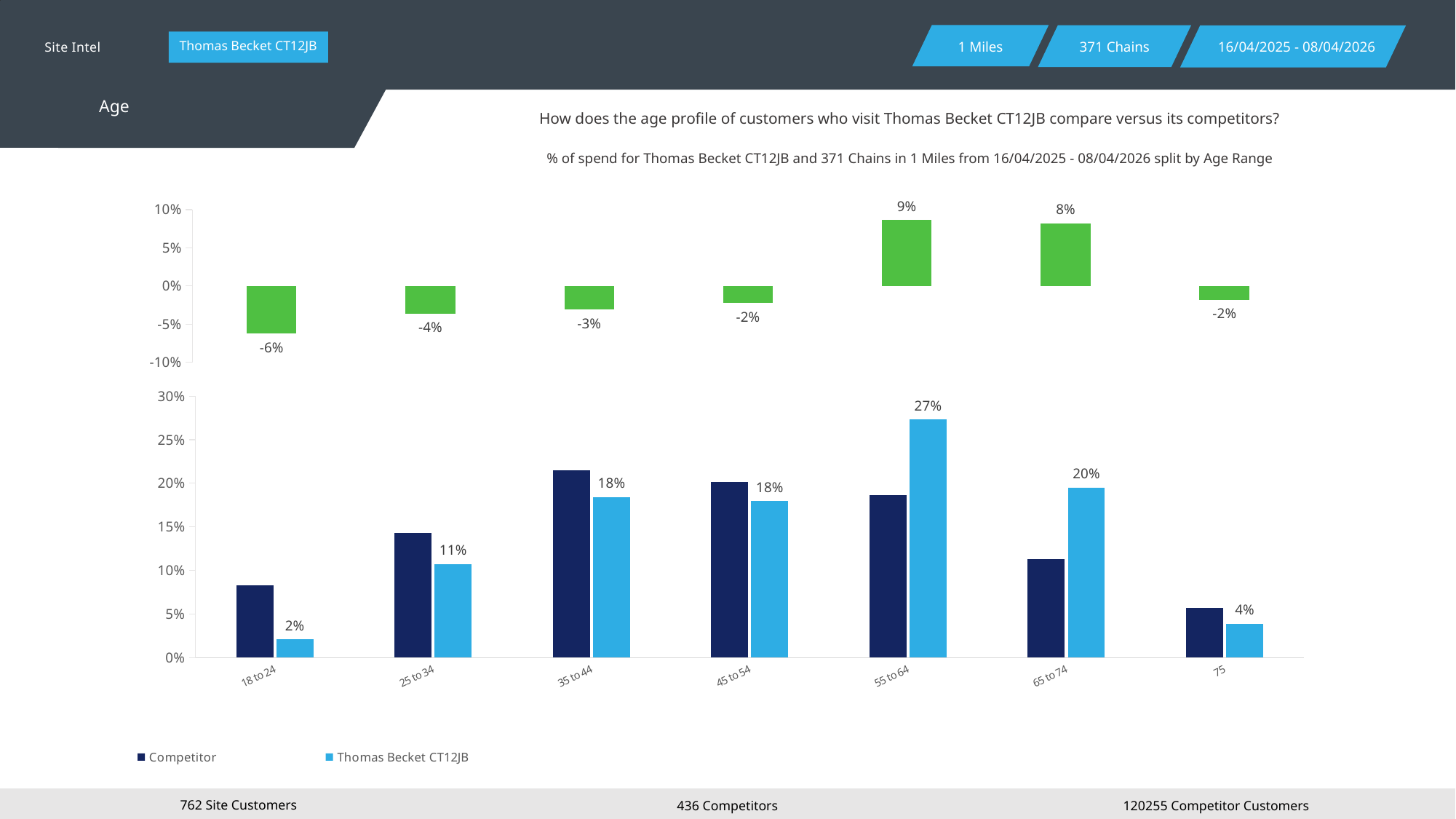
In the bottom chart, is the Competitor value for 18 to 24 greater or less than 10%? less In the top chart, what is the value shown for the 18 to 24 age range? -6% How many series does the legend of the bottom chart list? 2 How many age range categories are shown on the x axis of the bottom chart? 7 In the top chart, which age range has the highest value? 55 to 64 What kind of chart is the bottom chart? bar chart In the bottom chart, which age range has the highest value for Thomas Becket CT12JB? 55 to 64 In the bottom chart, what is the difference between the Thomas Becket CT12JB values for 55 to 64 and 18 to 24? 25 percentage points In the top chart, which age range has the lowest value? 18 to 24 In the bottom chart, for the 18 to 24 age range, which series has the larger value: Competitor or Thomas Becket CT12JB? Competitor In the bottom chart, is the Competitor value for 35 to 44 greater or less than 20%? greater In the bottom chart, what is the value for Thomas Becket CT12JB in the 55 to 64 age range? 27%